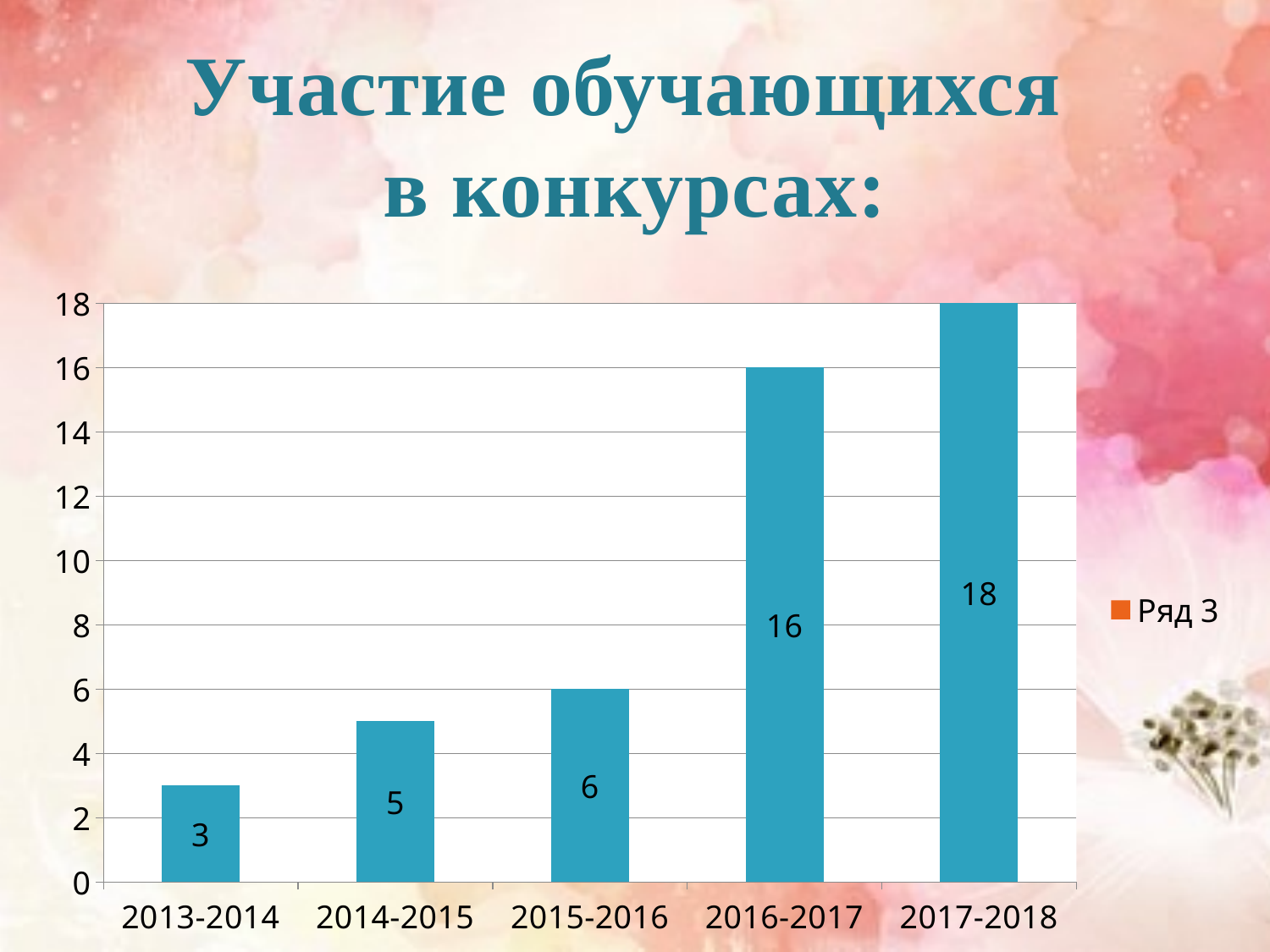
What is the value for 2015-2016? 6 What is the difference between the values for 2016-2017 and 2015-2016? 10 Which category has the highest value? 2017-2018 What is the value for 2016-2017? 16 How many categories are shown on the x axis? 5 Which is larger, the value for 2014-2015 or the value for 2015-2016? 2015-2016 Which category has the lowest value? 2013-2014 What is the value for 2013-2014? 3 Do the values rise or fall from 2013-2014 to 2017-2018? rise How many series does the legend list? 1 What is the difference between the values for 2017-2018 and 2016-2017? 2 What kind of chart is shown on the slide? bar chart